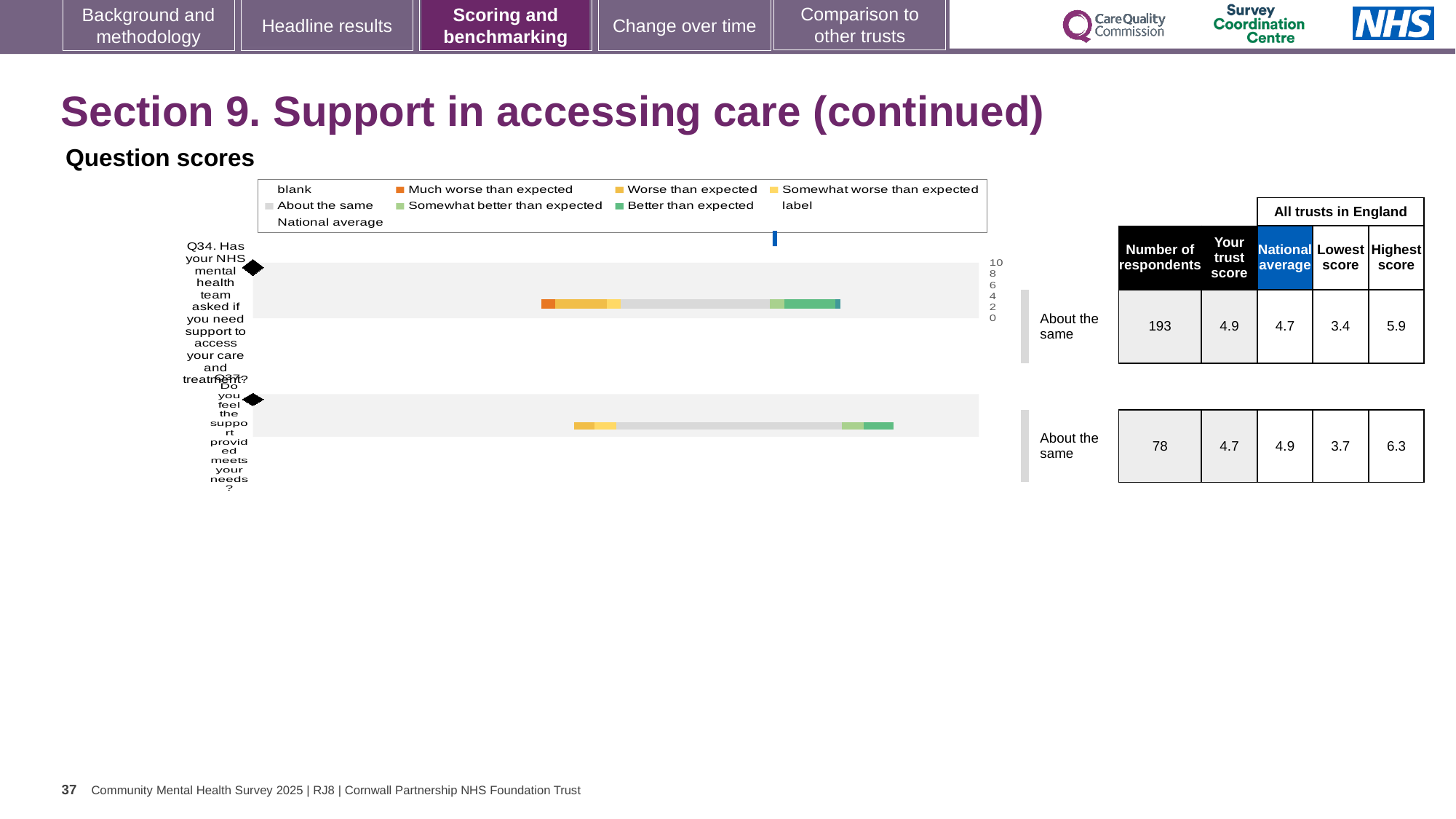
How many entries does the legend of the question scores chart list? 9 What is the difference between the highest score and the lowest score for Q34? 2.5 What kind of chart is used to show the question scores? bar chart Which is larger for Q34: the trust score or the national average? trust score What is the highest score across all trusts in England for Q37? 6.3 How many questions (categories) are plotted in the question scores chart? 2 What is the highest tick value shown on the score axis of the question scores chart? 10 Which legend entry in the question scores chart is shown in orange? Much worse than expected How many more respondents answered Q34 than Q37? 115 What is the number of respondents for Q34 in the question scores table? 193 What is the trust score for Q37 in the question scores table? 4.7 What is the national average for Q34 in the question scores table? 4.7